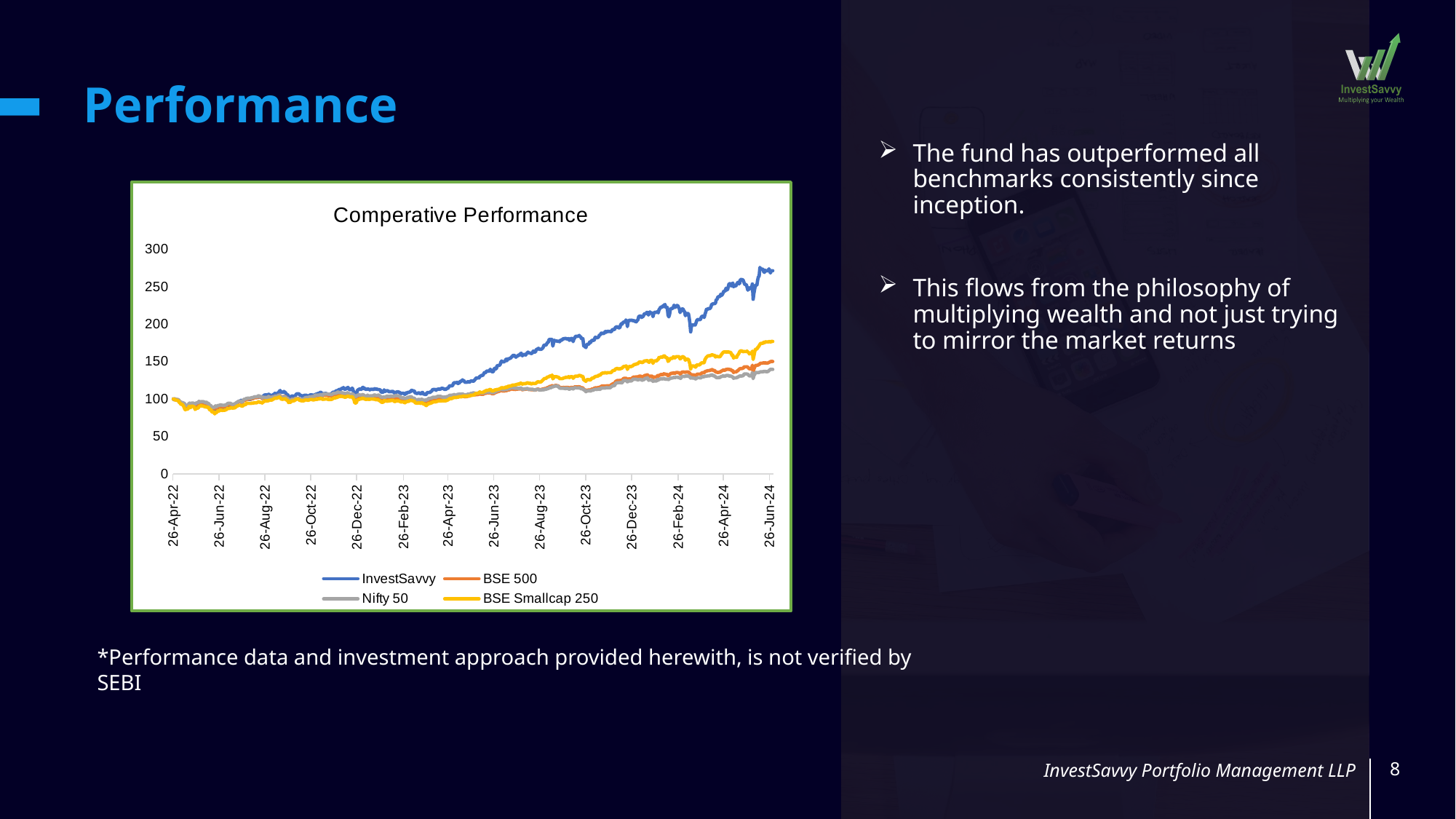
How many date labels are shown on the x axis of the chart? 14 Does the InvestSavvy line generally rise or fall from 26-Apr-22 to 26-Jun-24? Rise Is the value of BSE Smallcap 250 at 26-Jun-24 greater or less than 150? greater What is the title of the chart? Comperative Performance Is the value of Nifty 50 at 26-Jun-24 greater or less than 150? less Which series has the highest value at the end of the chart (26-Jun-24)? InvestSavvy What colour is the InvestSavvy line in the chart? Blue At what value do all four series start on 26-Apr-22? 100 How many series does the chart legend list? 4 At 26-Jun-24, which is larger: InvestSavvy or BSE Smallcap 250? InvestSavvy What type of chart is shown on the slide? Line chart Is the value of InvestSavvy at 26-Jun-24 greater or less than 250? greater